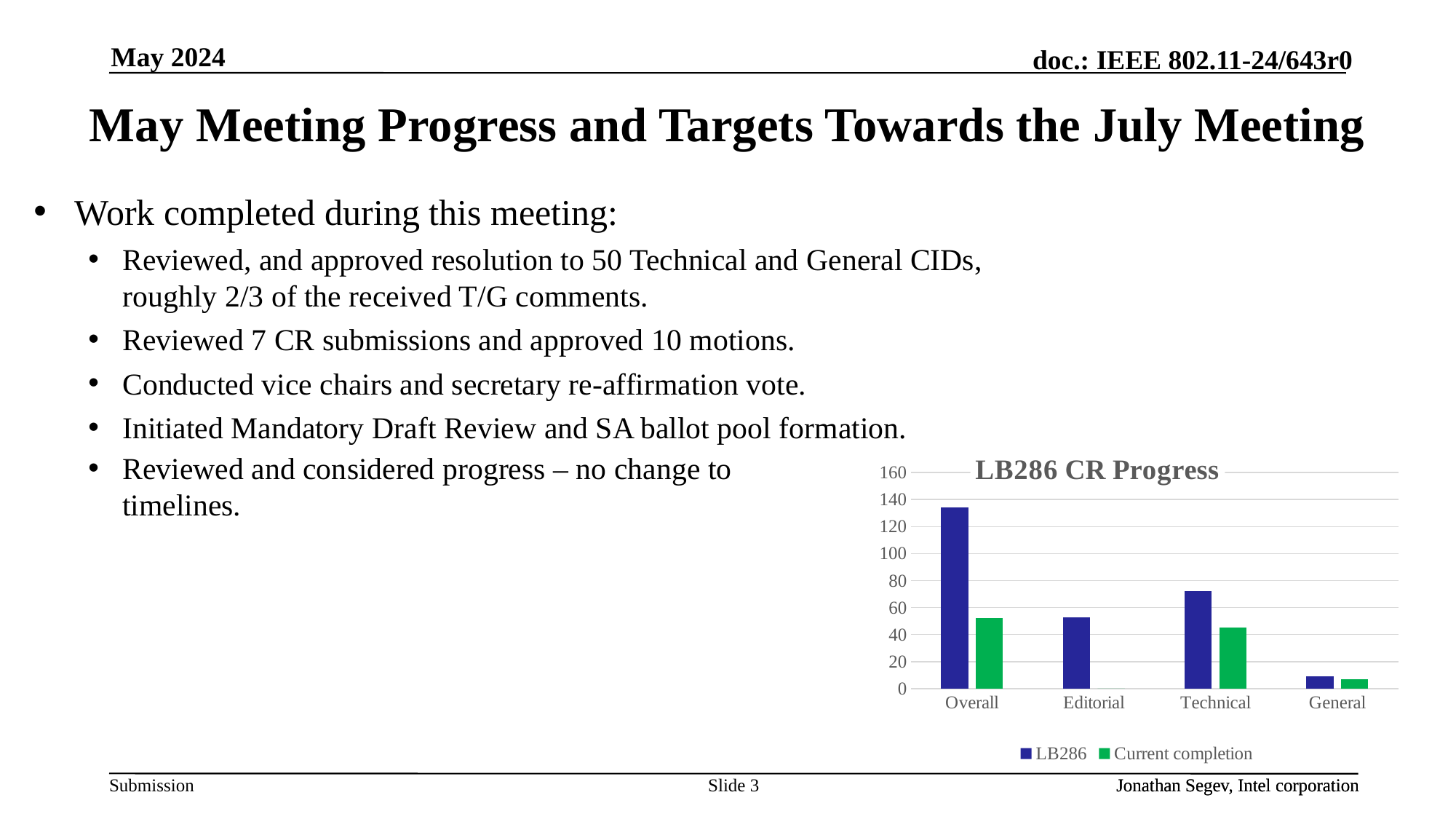
Is the Current completion value for Overall greater or less than 60? less What type of chart is shown on the slide? bar chart Which is larger, the LB286 value for Editorial or the LB286 value for Technical? Technical How many categories are shown on the x axis of the chart? 4 Which category has the highest LB286 value? Overall Which colour represents the LB286 series in the chart? blue Which category has the lowest LB286 value? General What is the title of the chart on the slide? LB286 CR Progress Is the LB286 value for General greater or less than 20? less How many series does the chart's legend list? 2 Is the LB286 value for Overall greater or less than 120? greater